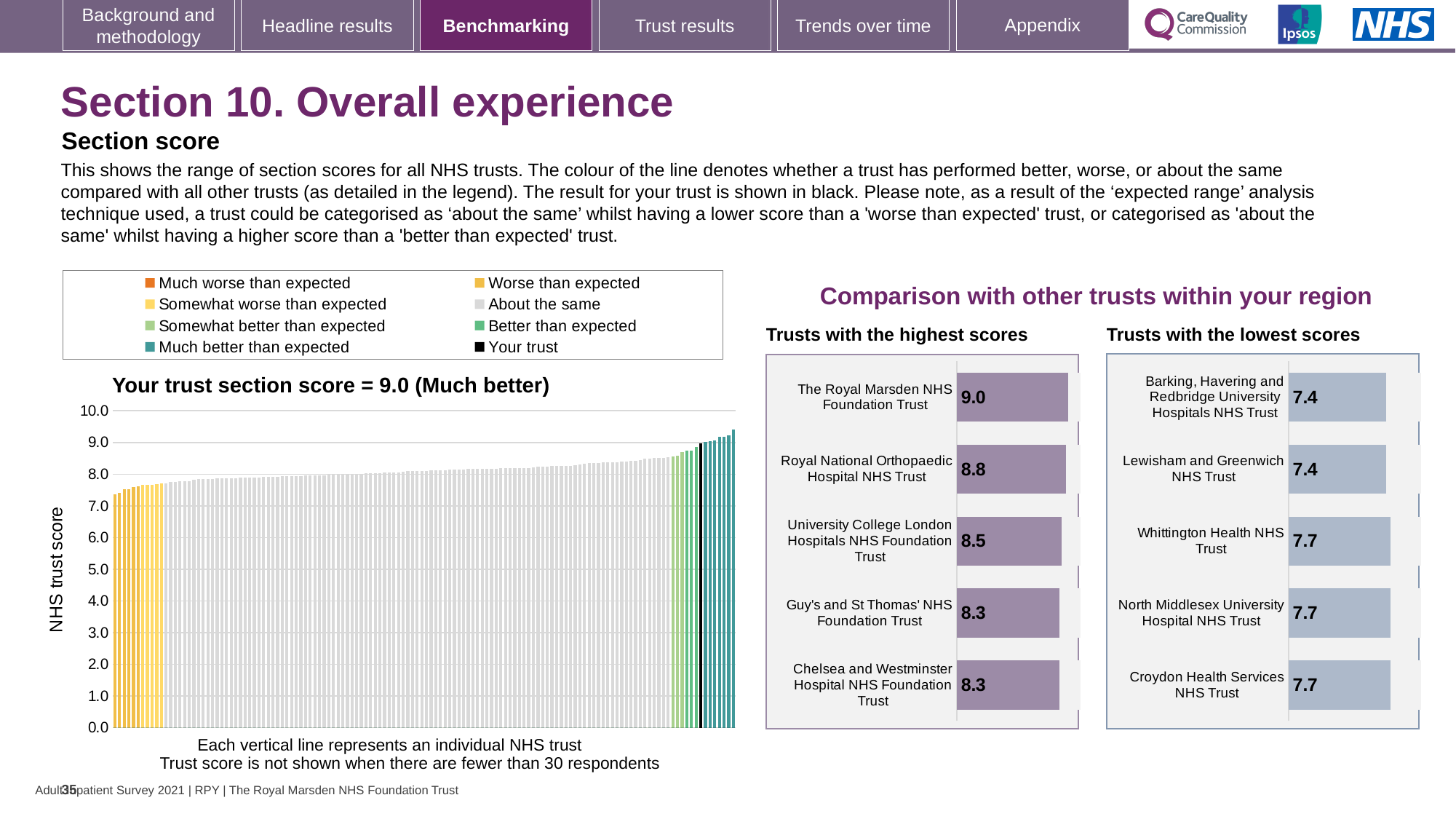
In the 'Trusts with the highest scores' chart, what is the score for University College London Hospitals NHS Foundation Trust? 8.5 In the 'Your trust section score' chart, what kind of chart is shown? Bar chart In the 'Trusts with the highest scores' chart, what is the score for The Royal Marsden NHS Foundation Trust? 9.0 In the 'Trusts with the lowest scores' chart, what is the difference between the scores of North Middlesex University Hospital NHS Trust and Lewisham and Greenwich NHS Trust? 0.3 In the 'Trusts with the lowest scores' chart, which is larger: the score for Whittington Health NHS Trust or the score for Barking, Havering and Redbridge University Hospitals NHS Trust? Whittington Health NHS Trust In the 'Trusts with the lowest scores' chart, what is the score for Croydon Health Services NHS Trust? 7.7 In the 'Trusts with the highest scores' chart, which trust has the highest score? The Royal Marsden NHS Foundation Trust In the 'Your trust section score' chart, is the value of the leftmost (lowest) bar greater or less than 8.0? less In the 'Trusts with the highest scores' chart, what is the difference between the scores of The Royal Marsden NHS Foundation Trust and Royal National Orthopaedic Hospital NHS Trust? 0.2 In the 'Your trust section score' chart, do the trust scores rise or fall from left to right along the x axis? Rise In the 'Trusts with the highest scores' chart, how many trusts are listed? 5 In the 'Trusts with the lowest scores' chart, what is the score for Lewisham and Greenwich NHS Trust? 7.4